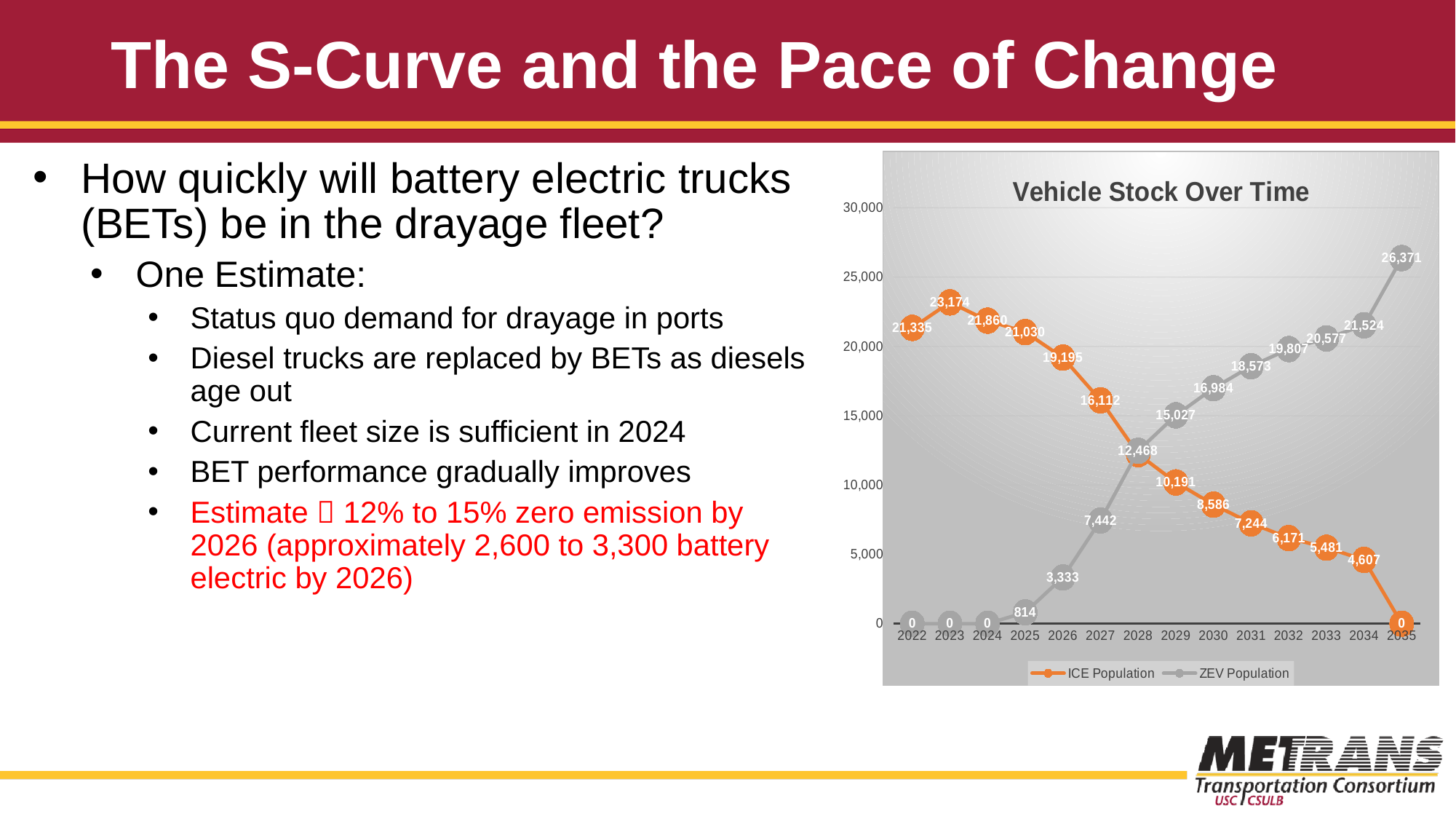
In 2030, which is larger: the ICE Population or the ZEV Population? ZEV Population What is the title of the chart? Vehicle Stock Over Time How many years are shown on the x axis? 14 What is the ICE Population value in 2034? 4,607 What is the ZEV Population value in 2026? 3,333 How many series does the legend list? 2 What is the difference between the ZEV Population in 2035 and in 2034? 4,847 What kind of chart is shown on the slide? Line chart In which year is the ICE Population at its highest? 2023 What is the ICE Population value in 2022? 21,335 Does the ZEV Population rise or fall from 2025 to 2035? Rise What is the ZEV Population value in 2035? 26,371